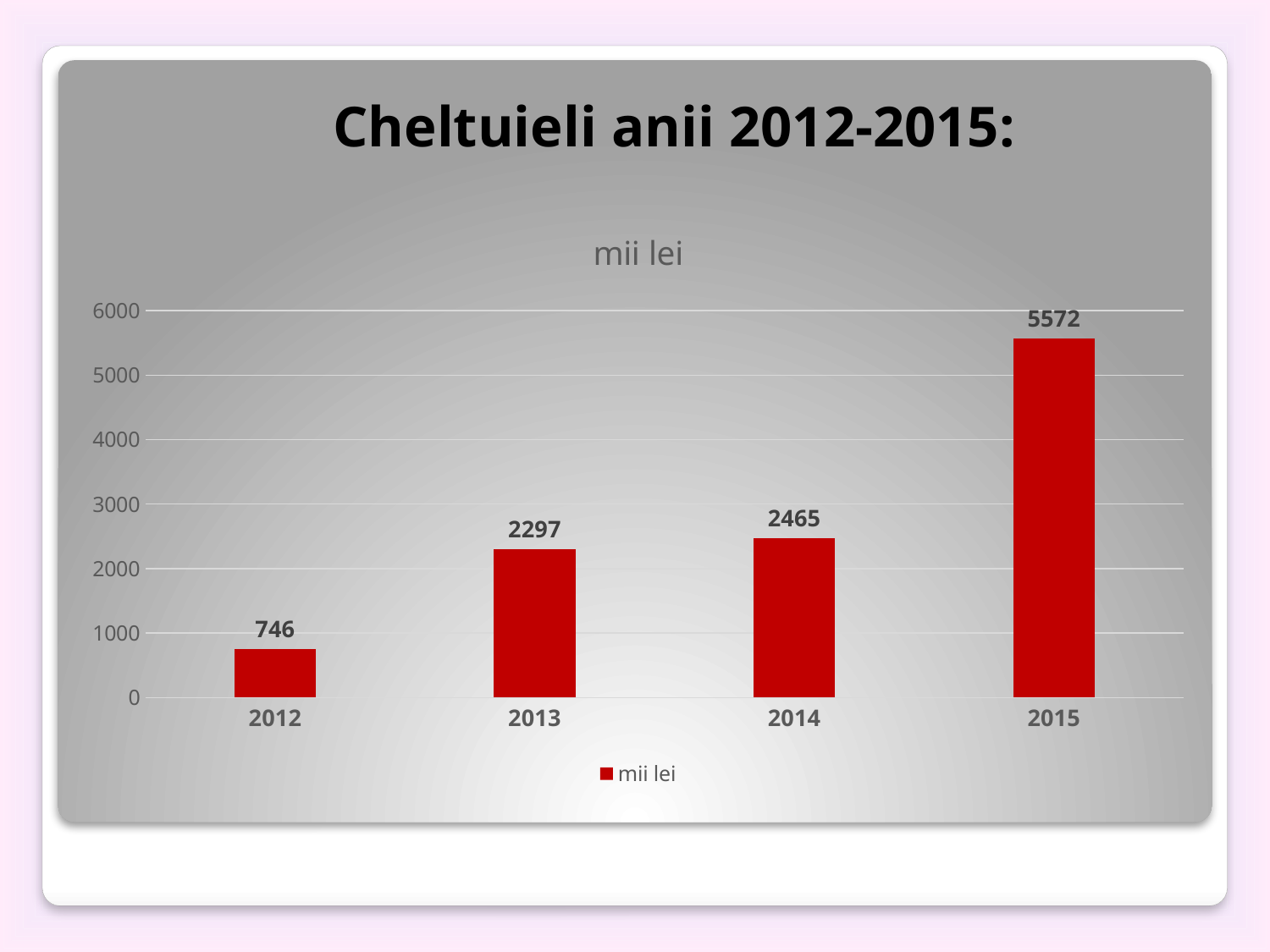
What is the difference between the values for 2013 and 2012? 1551 What is the value for 2014? 2465 What is the difference between the values for 2015 and 2014? 3107 Which is larger, the value for 2013 or the value for 2014? 2014 Which year has the highest value? 2015 What is the value for 2015? 5572 What kind of chart is shown on the slide? bar chart What is the value for 2013? 2297 What is the value for 2012? 746 How many years are shown on the x axis? 4 Do the values rise or fall from 2012 to 2015? rise Which year has the lowest value? 2012